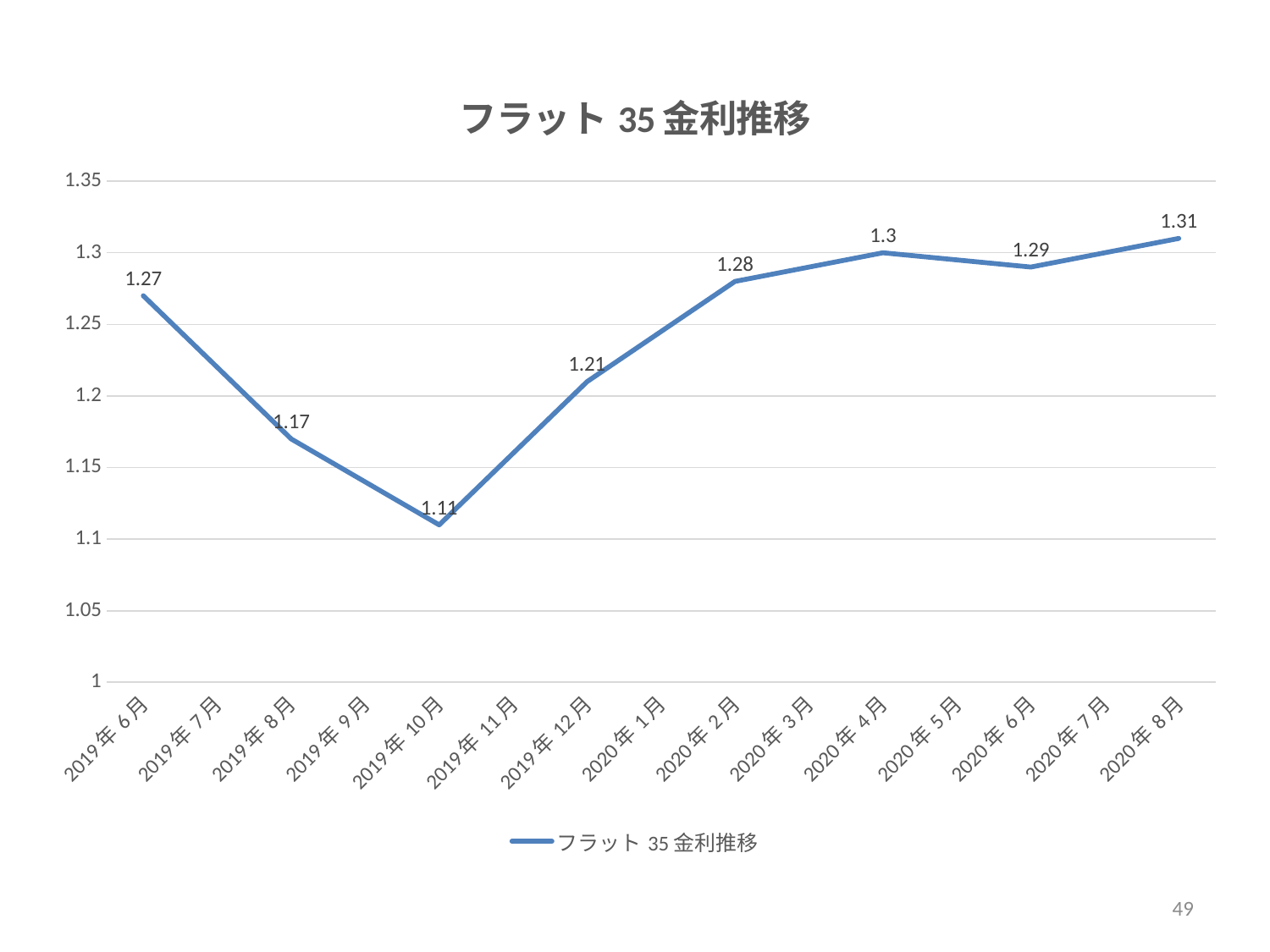
What kind of chart is this? line chart Which is larger, the value for 2019年6月 or the value for 2020年2月? 2020年2月 What is the difference between the values for 2020年8月 and 2019年10月? 0.2 What is the value for 2019年10月? 1.11 Which month has the lowest value? 2019年10月 Which month has the highest value? 2020年8月 Does the value rise or fall from 2019年10月 to 2020年4月? rise What is the value for 2020年4月? 1.3 How many months are shown on the x axis? 15 What is the value for 2019年6月? 1.27